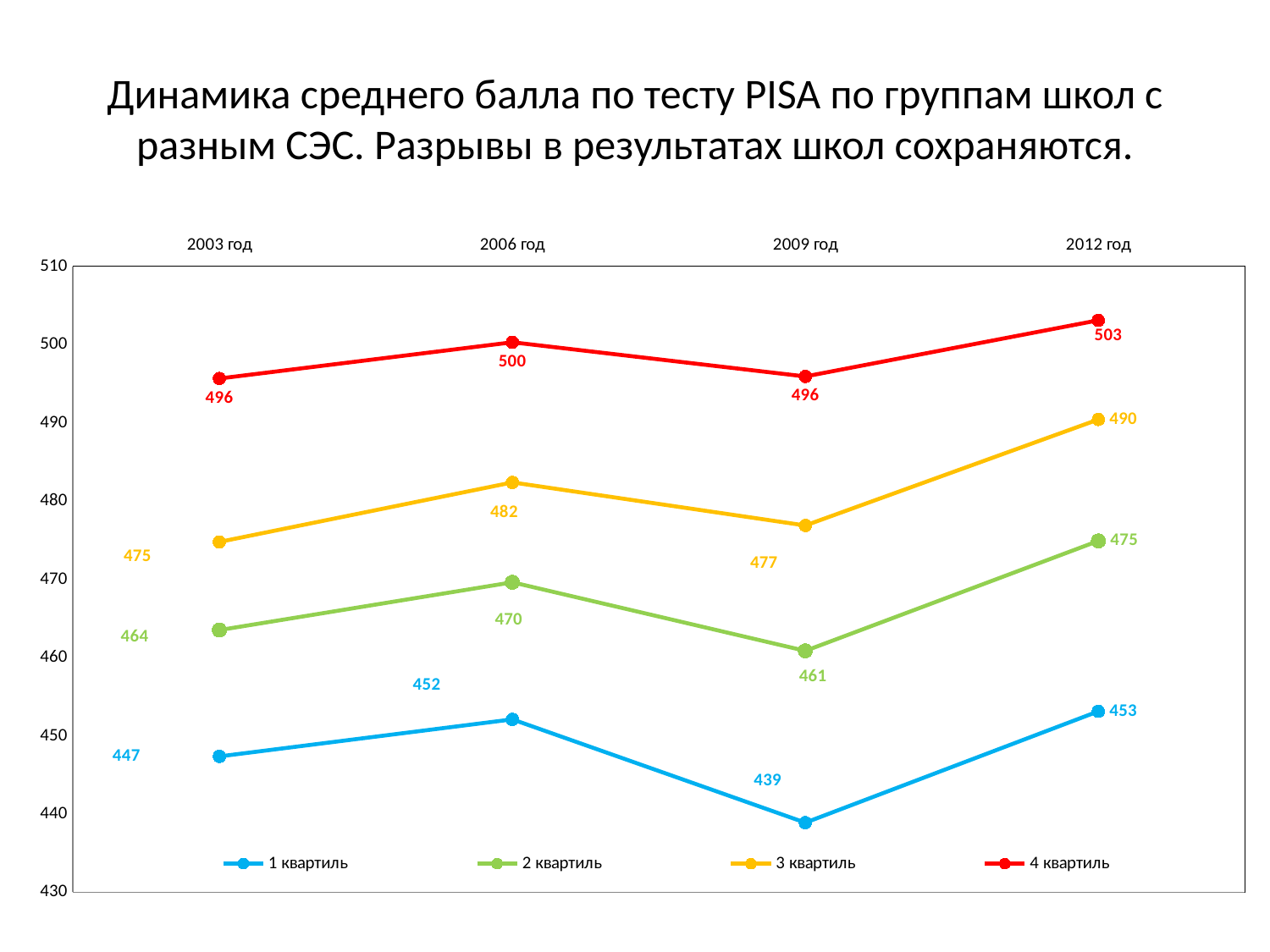
Does the value for 3 квартиль rise or fall from 2009 год to 2012 год? Rise Which is larger: 2 квартиль in 2006 год or 2 квартиль in 2009 год? 2 квартиль in 2006 год How many series does the legend list? 4 In which year is the value for 1 квартиль lowest? 2009 год What kind of chart is shown on the slide? Line chart What is the value for 2 квартиль in 2003 год? 464 In which year is the value for 3 квартиль highest? 2012 год What is the value for 4 квартиль in 2012 год? 503 How many years are shown on the x axis? 4 What is the difference between 4 квартиль and 1 квартиль in 2012 год? 50 What is the value for 3 квартиль in 2006 год? 482 What is the value for 1 квартиль in 2009 год? 439